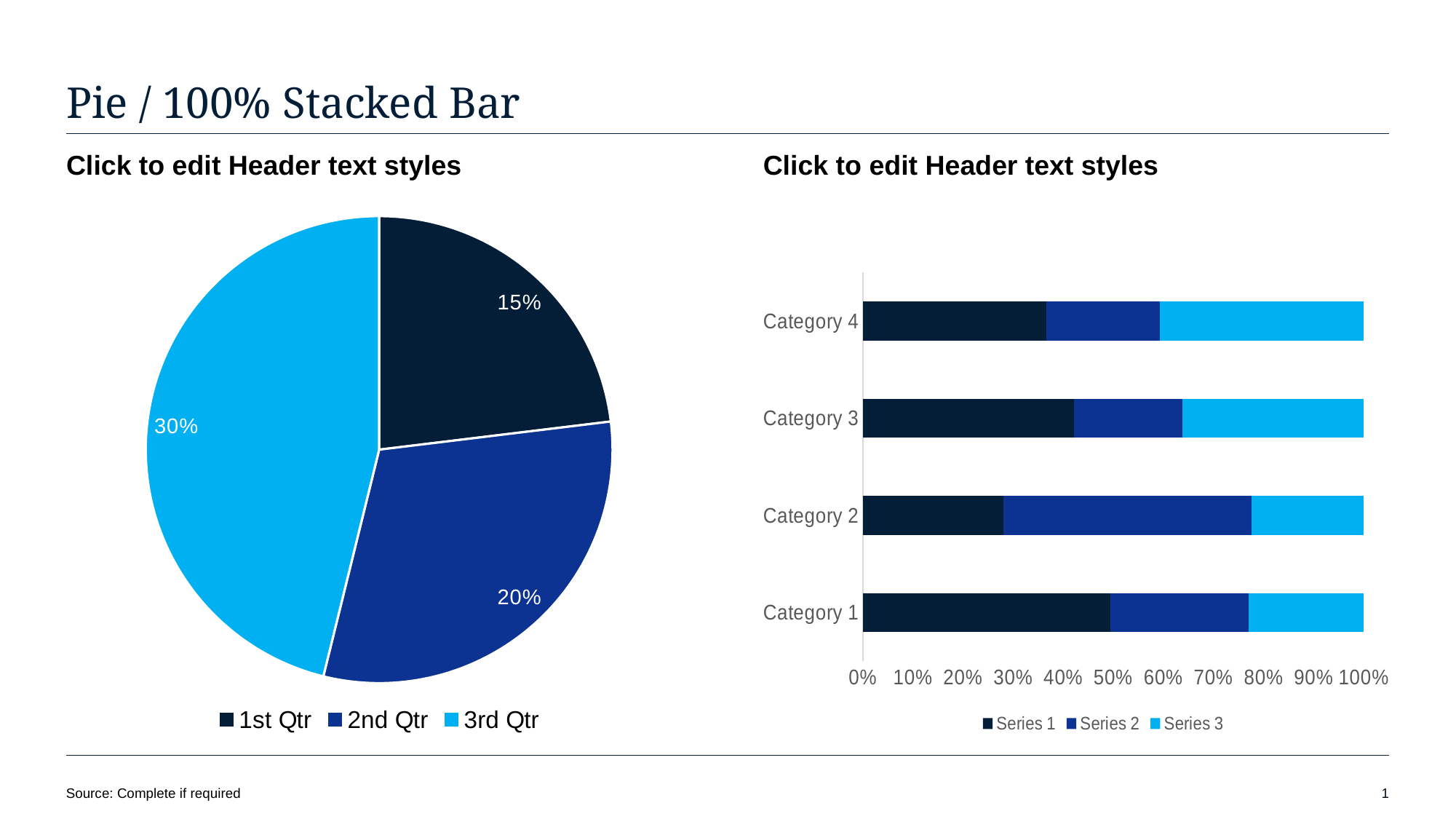
In the pie chart on the left, which slice is the smallest? 1st Qtr In the stacked bar chart on the right, is the Series 1 value for Category 4 greater or less than 30%? greater What kind of chart is the chart on the right of the slide? bar chart In the stacked bar chart on the right, how many categories are shown? 4 In the pie chart on the left, what share does 1st Qtr have? 15% In the stacked bar chart on the right, which category has the largest Series 2 segment? Category 2 In the pie chart on the left, which slice is the largest? 3rd Qtr In the stacked bar chart on the right, how many series does the legend list? 3 In the pie chart on the left, how many slices are there? 3 In the pie chart on the left, what is the difference between the 3rd Qtr and 1st Qtr shares? 15% In the pie chart on the left, what share does 3rd Qtr have? 30% What kind of chart is the chart on the left of the slide? pie chart